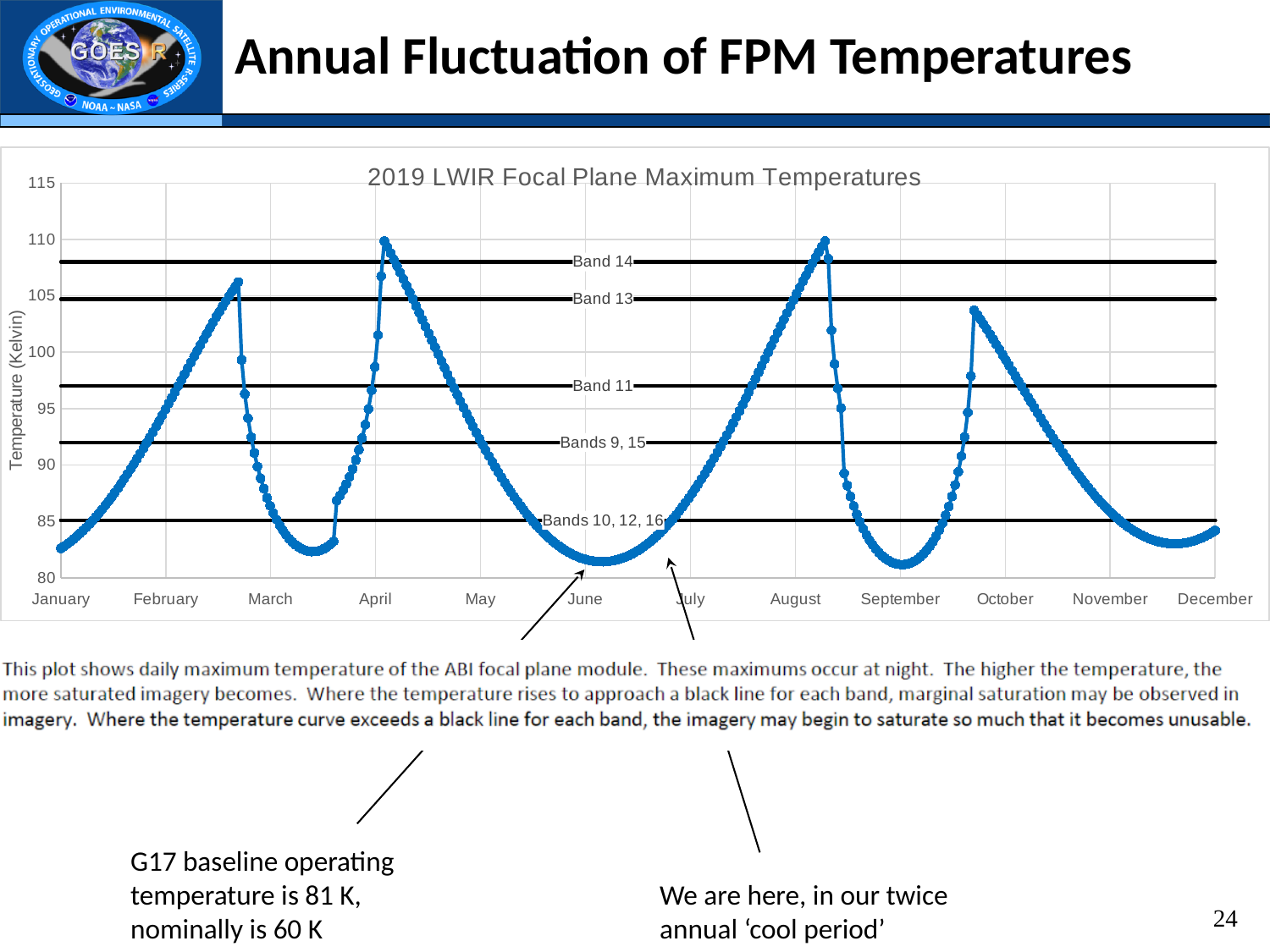
Is the temperature at the start of January greater or less than 85? less Is the minimum temperature reached in June greater or less than 85? less Does the temperature rise or fall from the start of January to late February? rise What is the label of the y axis? Temperature (Kelvin) How many horizontal black band lines are drawn on the chart? 5 How many months are labelled along the x axis? 12 Which band line sits at the lowest temperature? Bands 10, 12, 16 Is the peak temperature reached in early April greater or less than 105? greater Which band line sits at the highest temperature? Band 14 What kind of chart is shown on the slide? line chart What is the title of the chart? 2019 LWIR Focal Plane Maximum Temperatures